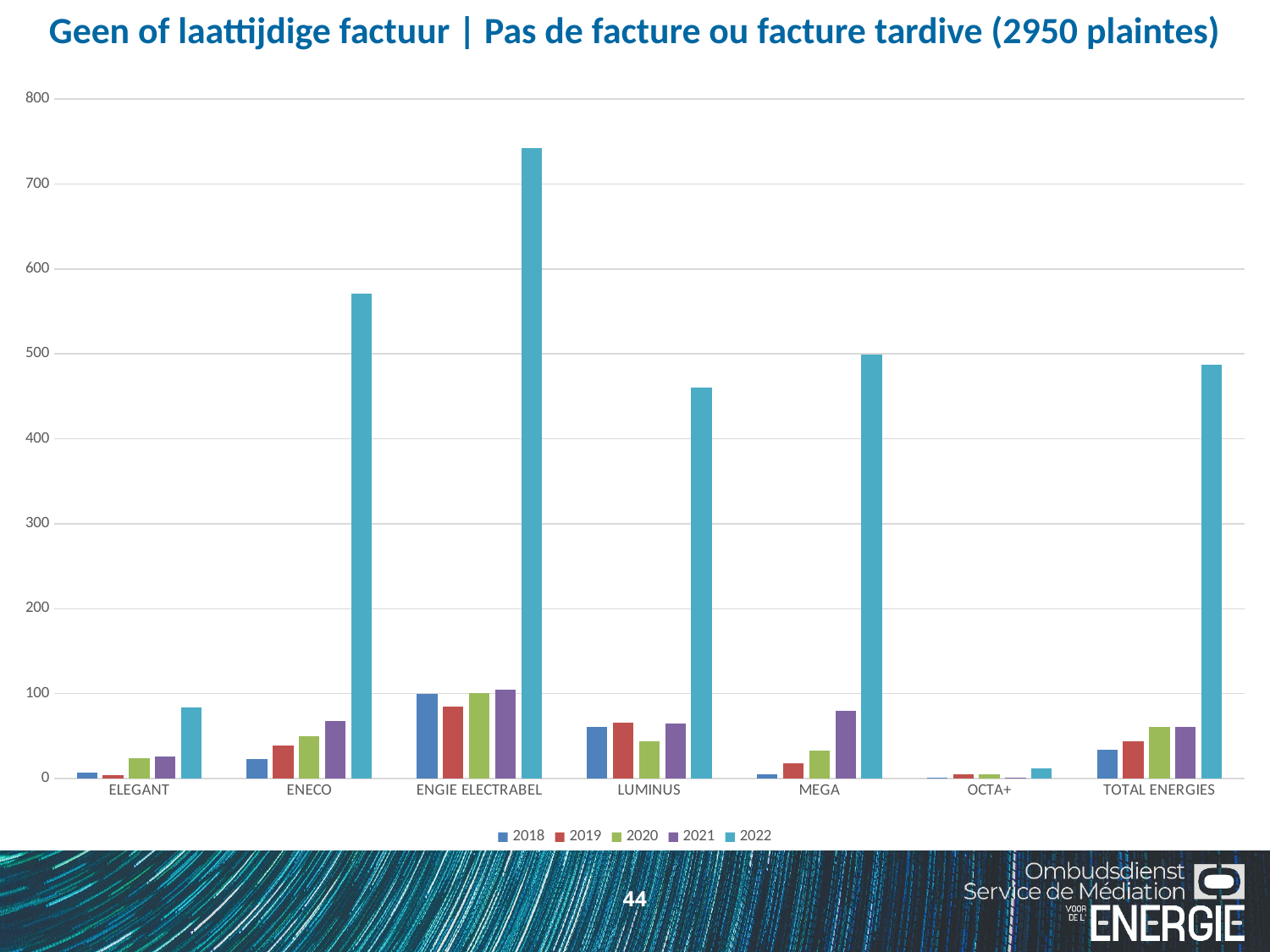
How many suppliers (categories) are shown on the x axis? 7 Which is larger: the 2022 value for ENECO or the 2022 value for LUMINUS? ENECO How many complaints does the chart title say the chart covers? 2950 What kind of chart is shown on the slide? bar chart Is the 2022 value for ENECO greater or less than 500? greater Which supplier has the highest value for 2022? ENGIE ELECTRABEL Do the values for ENECO rise or fall from 2018 to 2022? rise Which is larger: the 2018 value for ENGIE ELECTRABEL or the 2018 value for ELEGANT? ENGIE ELECTRABEL Is the 2022 value for LUMINUS greater or less than 500? less Is the 2022 value for ENGIE ELECTRABEL greater or less than 700? greater Which supplier has the lowest value for 2022? OCTA+ How many series does the legend list? 5